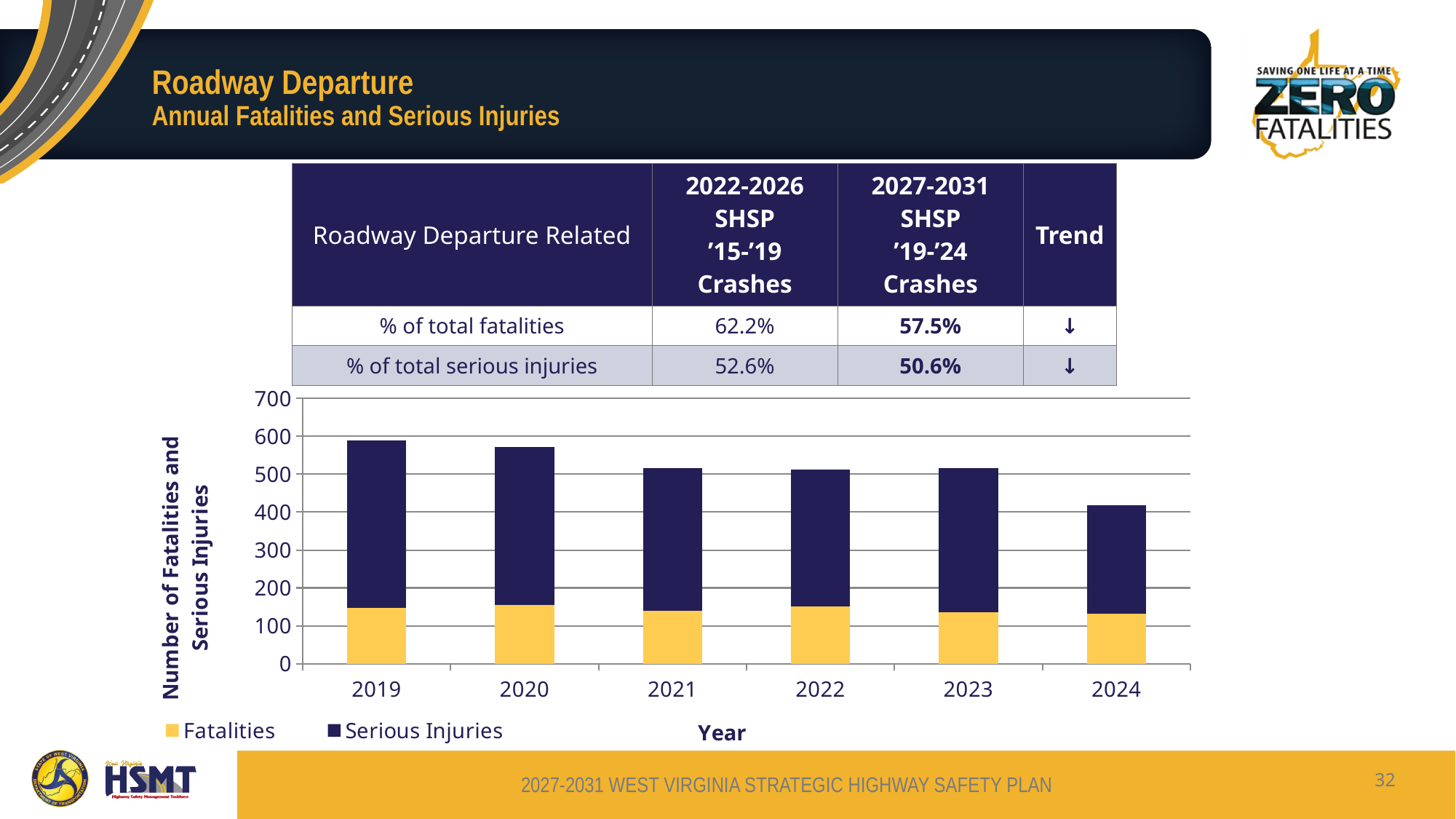
How many series does the chart legend list? 2 Which year has the tallest stacked bar in the chart? 2019 Which series is shown in yellow in the chart? Fatalities How many years are shown on the x axis of the chart? 6 Which year has the larger total bar, 2019 or 2024? 2019 Is the total bar height for 2024 greater or less than 500? less Is the Fatalities value for 2020 greater or less than 100? greater Do the total bar heights generally rise or fall from 2019 to 2024? fall What kind of chart is shown on the slide? stacked bar chart Which year has the shortest stacked bar in the chart? 2024 Is the Fatalities value for 2024 greater or less than 200? less